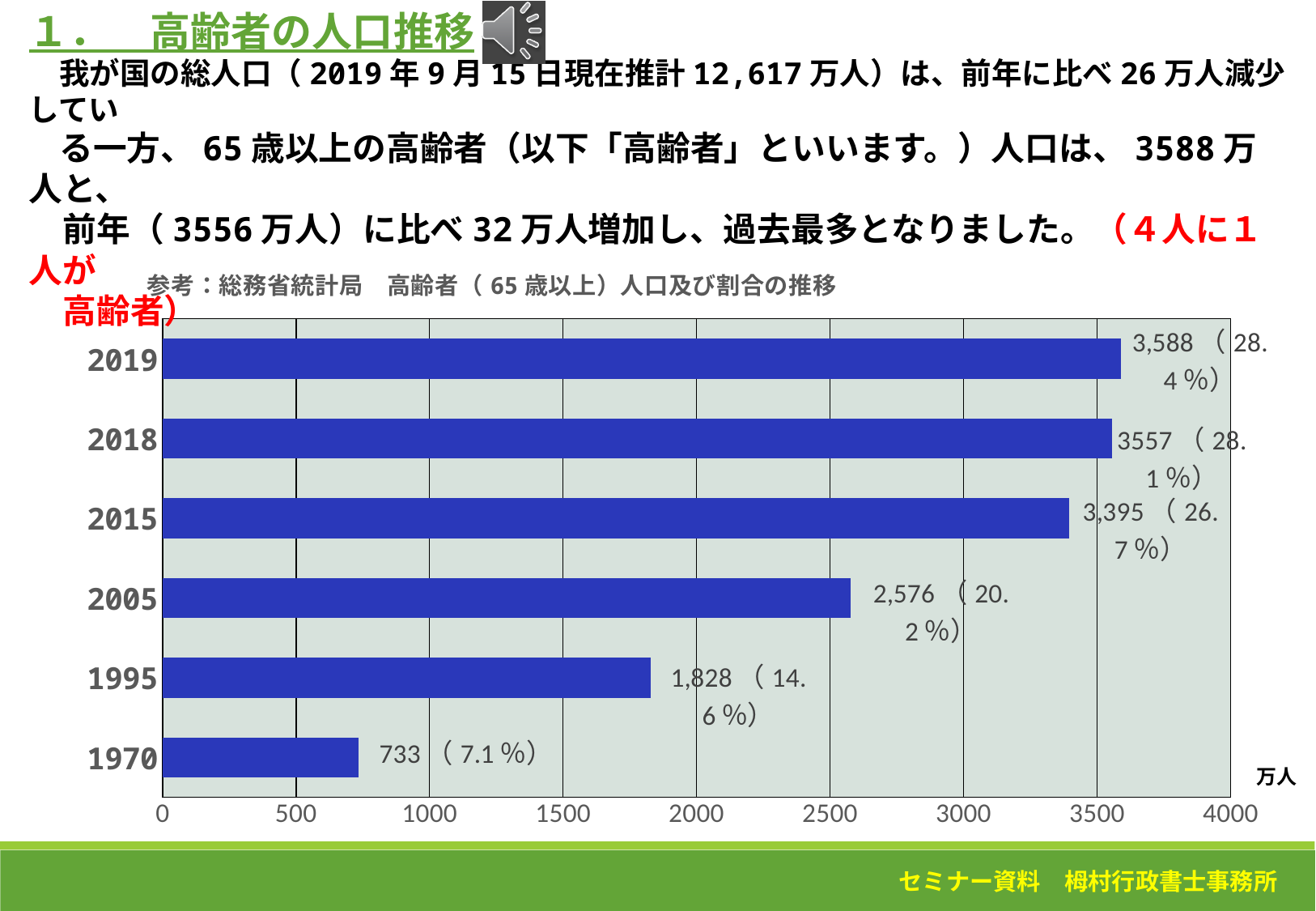
What is the value shown for 1970? 733 Which year has the lowest value in the chart? 1970 What is the difference between the values for 1995 and 1970? 1,095 Is the value for 1995 greater or less than 2000? less How many years (bars) are shown in the chart? 6 What kind of chart is shown on the slide? bar chart What is the value shown for 2019 in the chart? 3,588 Going from 1970 to 2019, do the values rise or fall? rise What percentage is shown next to the 2005 bar? 20.2% Which is larger, the value for 2015 or the value for 2005? 2015 What is the difference between the values for 2015 and 2005? 819 Which year has the highest value in the chart? 2019